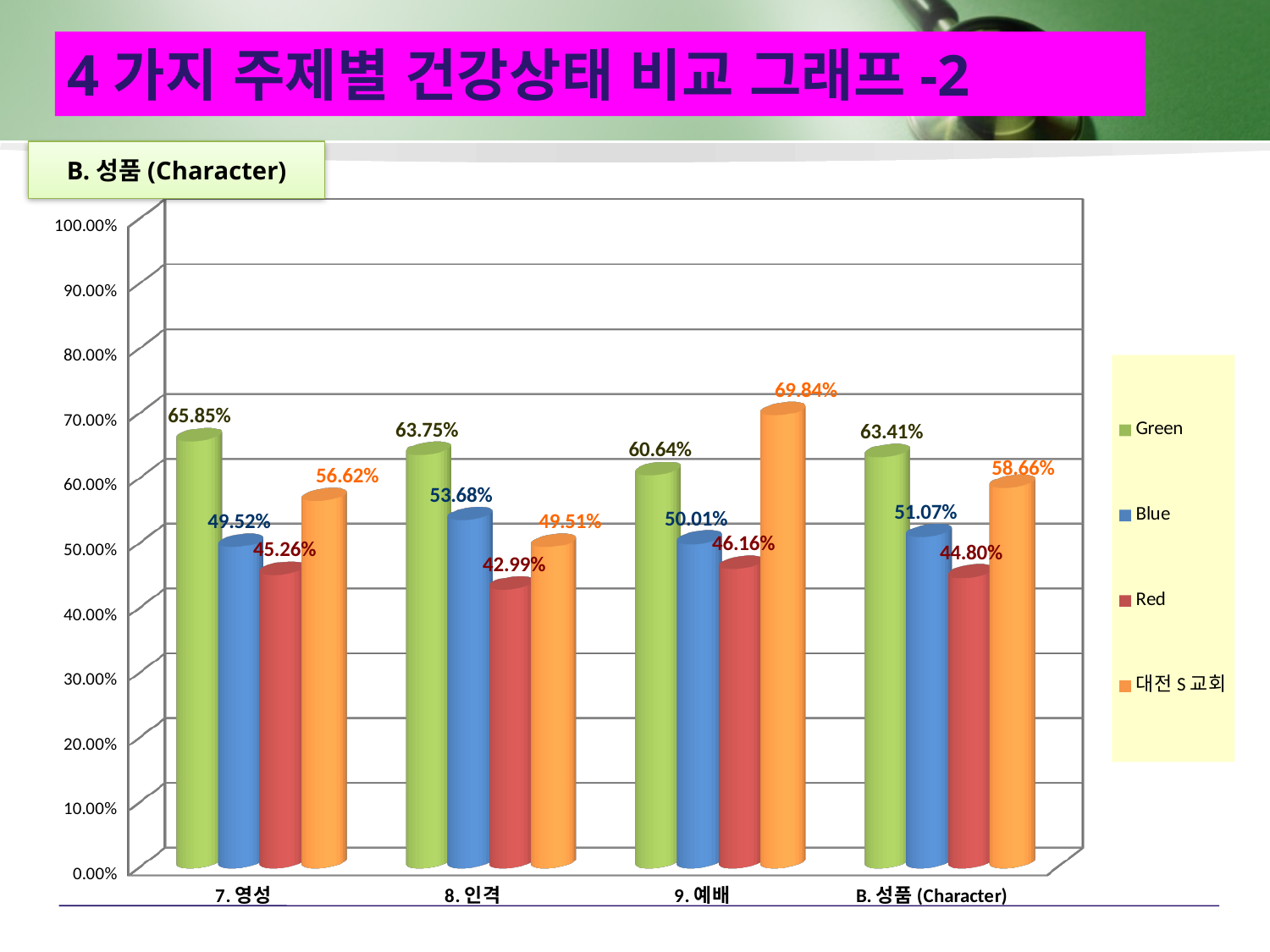
Which is larger for 8. 인격: the Blue value or the 대전 S 교회 value? Blue What is the value of the Red series for 8. 인격? 42.99% Which category has the lowest value for the Red series? 8. 인격 Which category has the highest value for the 대전 S 교회 series? 9. 예배 How many series does the legend list? 4 How many categories are shown on the x axis? 4 Is the Green value for 9. 예배 greater or less than 70.00%? less What is the value of the Green series for 7. 영성? 65.85% What is the value of the 대전 S 교회 series for 9. 예배? 69.84% What is the value of the Blue series for B. 성품 (Character)? 51.07% What kind of chart is shown on the slide? bar chart What is the difference between the Green and Blue values for 7. 영성? 16.33%